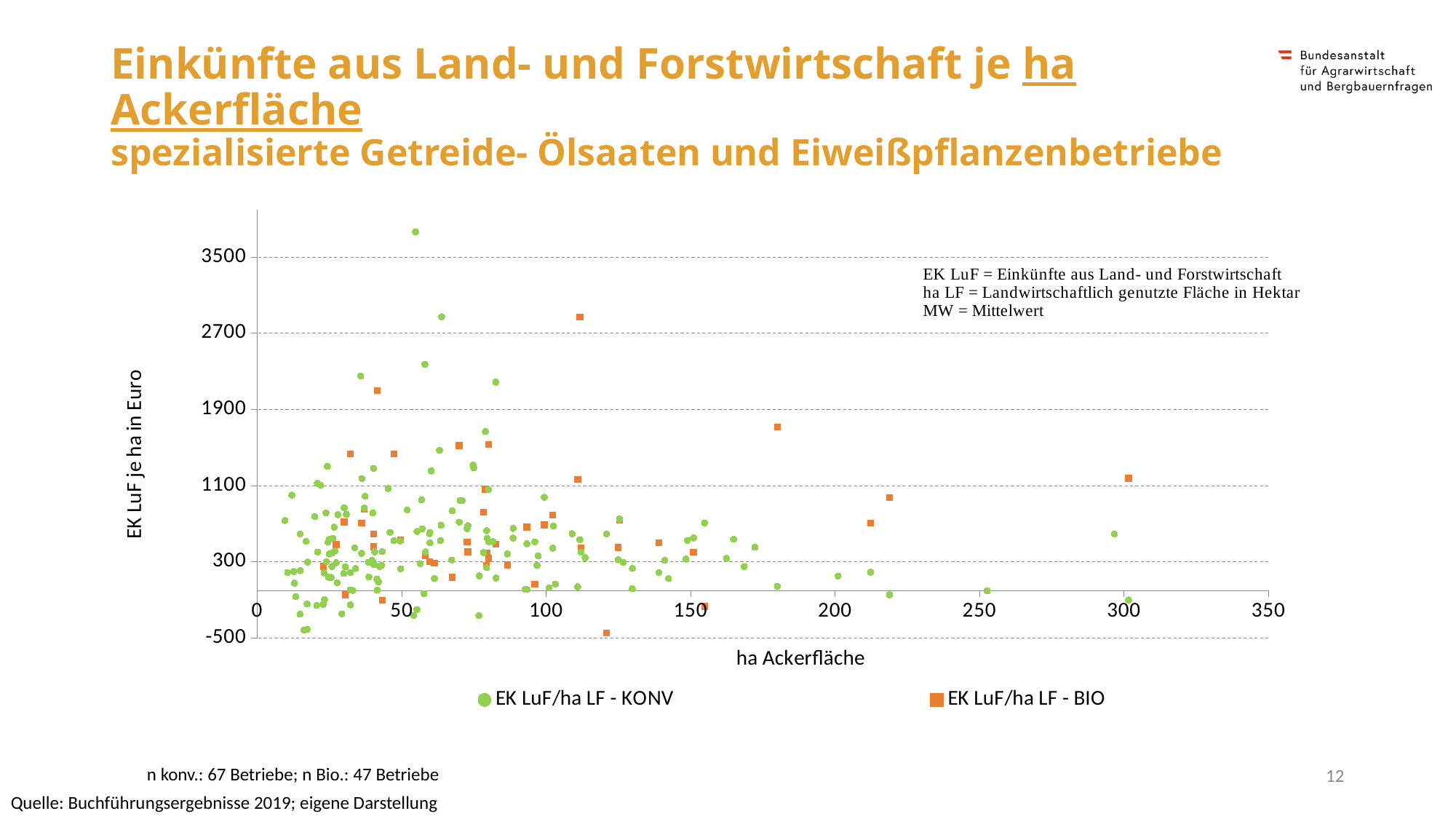
Which series contains the single highest EK LuF je ha value in the chart, KONV or BIO? EK LuF/ha LF - KONV According to the note below the chart, how many Bio-Betriebe are included? 47 Betriebe Is the EK LuF/ha LF - BIO point at about 180 ha Ackerfläche greater or less than 1900? less How many series does the legend list? 2 Is the EK LuF/ha LF - KONV point at about 300 ha Ackerfläche greater or less than 1100? less What is the label of the x axis? ha Ackerfläche What is the label of the y axis? EK LuF je ha in Euro Is the highest EK LuF/ha LF - BIO point greater or less than 2700? greater What is the highest value shown on the y axis? 3500 What kind of chart is shown on the slide? scatter chart According to the note below the chart, how many konventionelle Betriebe are included? 67 Betriebe